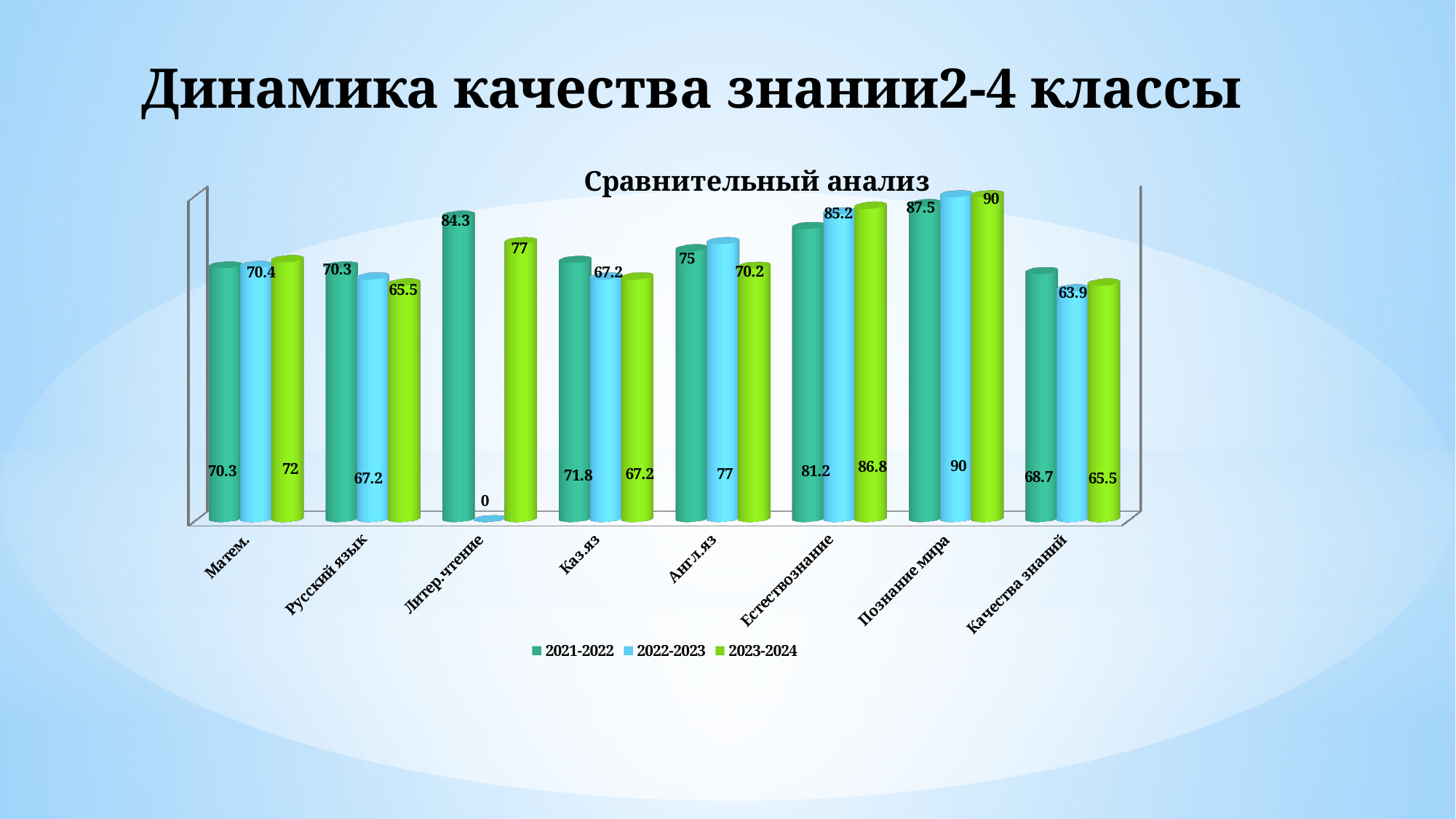
Which category has the lowest value in the 2022-2023 series? Литер.чтение Which category has the highest value in the 2021-2022 series? Познание мира What is the value for Литер.чтение in the 2021-2022 series? 84.3 How many categories are shown on the x axis? 8 What kind of chart is shown? bar chart How many series does the legend list? 3 What is the value for Познание мира in the 2023-2024 series? 90 What is the value for Качества знаний in the 2022-2023 series? 63.9 What is the difference between the 2023-2024 and 2021-2022 values for Естествознание? 5.6 Which is larger for Англ.яз: the 2022-2023 value or the 2023-2024 value? 2022-2023 What is the value for Естествознание in the 2023-2024 series? 86.8 What is the title of the chart? Сравнительный анализ